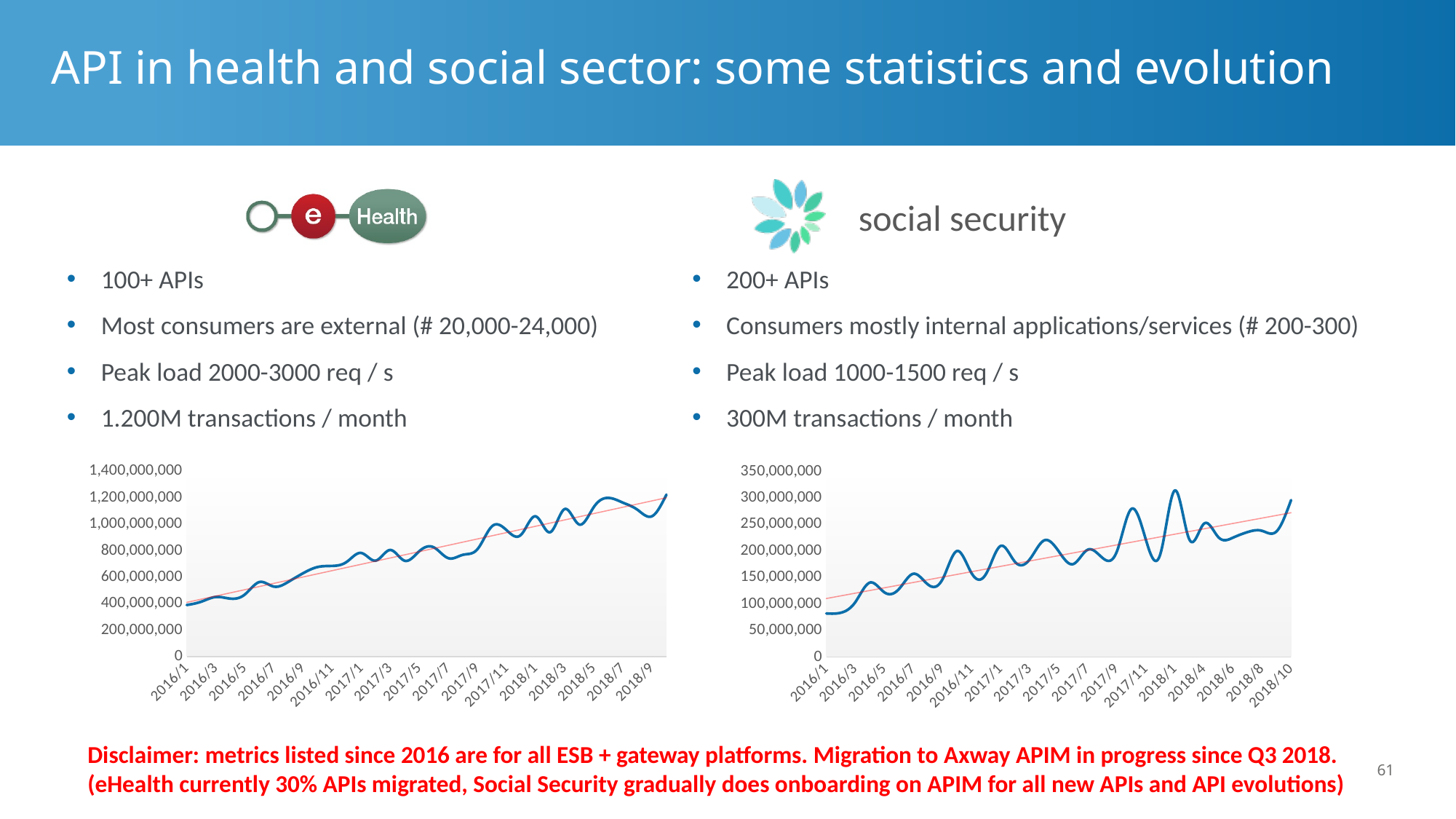
In the right chart, is the value for 2016/1 greater or less than 100,000,000? less In the left chart, is the value for 2017/1 greater or less than 600,000,000? greater In the left chart, is the value for 2018/5 greater or less than 1,000,000,000? greater In the right chart, do the values generally rise or fall from 2016/1 to 2018/10? rise What kind of chart is the right chart under the social security bullets? line chart In the left chart, do the values generally rise or fall from 2016/1 to 2018/9? rise What is the highest value shown on the y axis of the left chart? 1,400,000,000 What kind of chart is the left chart under the eHealth bullets? line chart What is the last x-axis label on the right chart? 2018/10